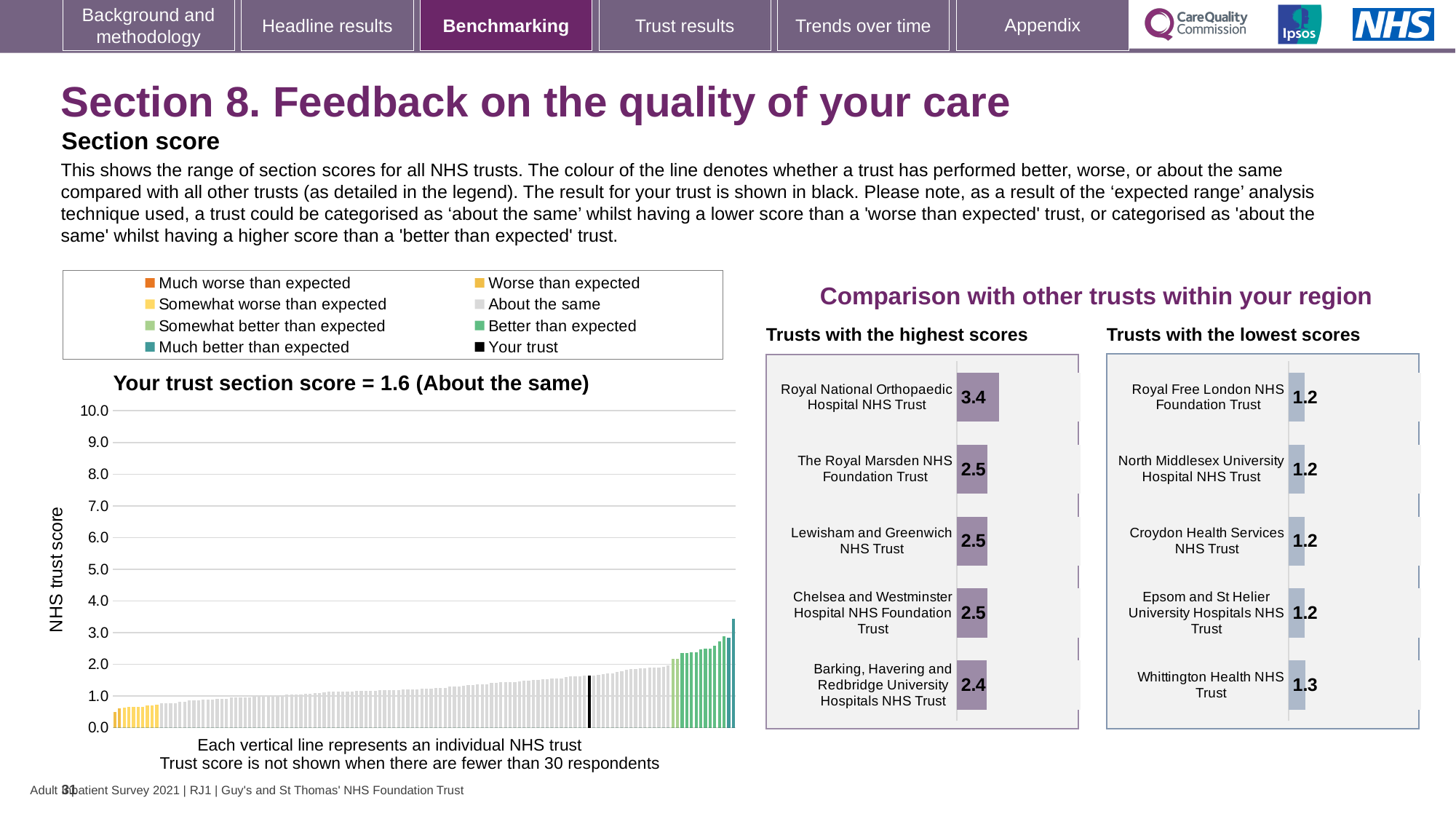
In the 'Trusts with the lowest scores' chart, which trust has the highest score? Whittington Health NHS Trust In the 'Trusts with the lowest scores' chart, what is the score for Whittington Health NHS Trust? 1.3 What kind of chart is the 'Your trust section score' chart? bar chart How many trusts are shown in the 'Trusts with the highest scores' chart? 5 In the 'Trusts with the highest scores' chart, which trust has the highest score? Royal National Orthopaedic Hospital NHS Trust In the 'Your trust section score' chart, what is the section score for your trust? 1.6 In the 'Your trust section score' chart, what is the highest value shown on the y axis? 10.0 In the 'Trusts with the lowest scores' chart, what is the difference between the score for Whittington Health NHS Trust and the score for Royal Free London NHS Foundation Trust? 0.1 In the 'Your trust section score' chart, do the trust scores rise or fall from left to right along the x axis? rise How many entries does the legend above the 'Your trust section score' chart list? 8 In the 'Trusts with the highest scores' chart, what is the score for Royal National Orthopaedic Hospital NHS Trust? 3.4 In the 'Trusts with the highest scores' chart, what is the difference between the score for Royal National Orthopaedic Hospital NHS Trust and the score for Barking, Havering and Redbridge University Hospitals NHS Trust? 1.0